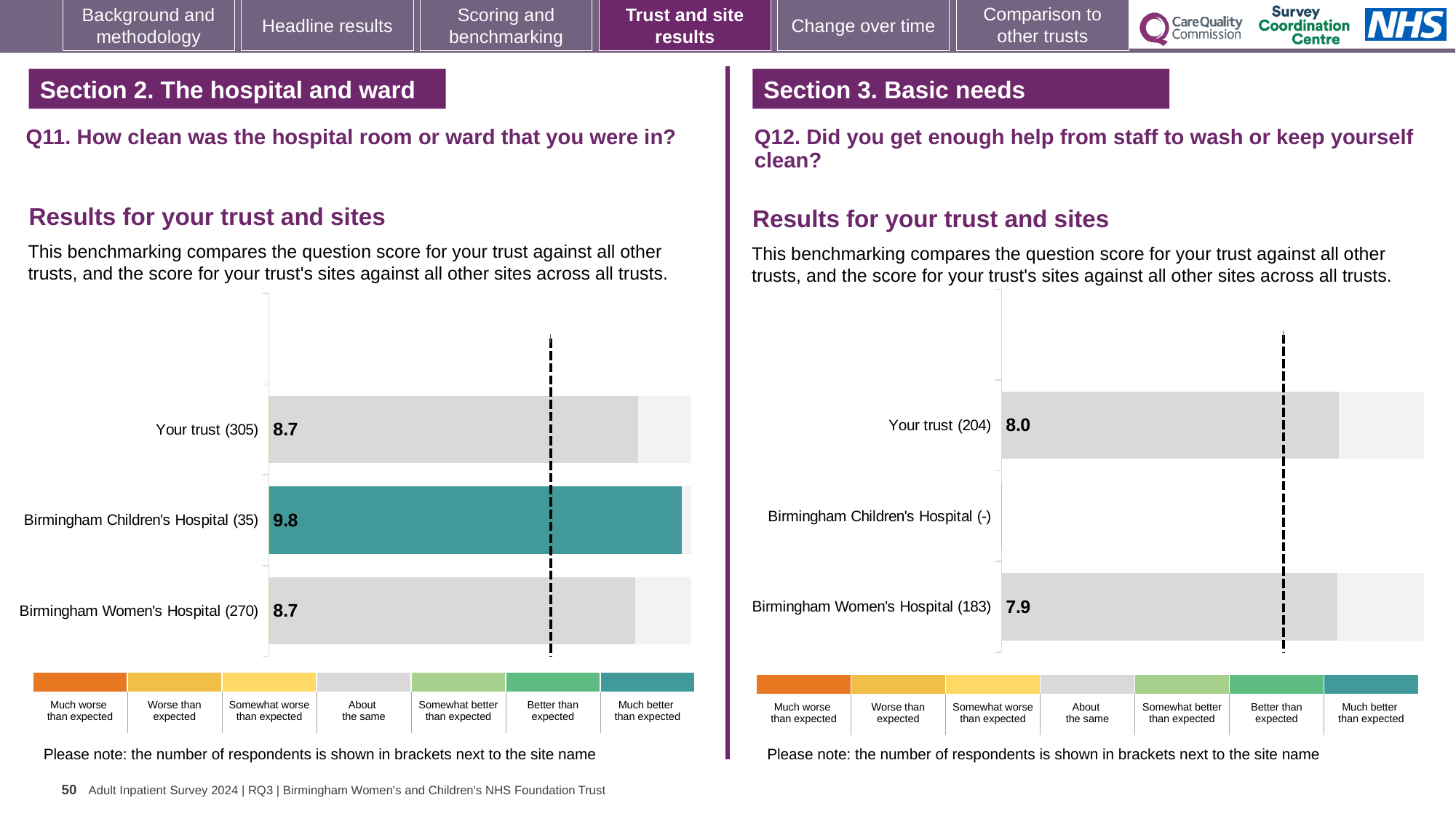
In the Q11 chart on the left, how many bars are plotted? 3 In the Q12 chart on the right, what is the score for Your trust? 8.0 In the Q11 chart on the left, what is the score for Birmingham Children's Hospital? 9.8 In the Q12 chart on the right, what is the score for Birmingham Women's Hospital? 7.9 In the Q11 chart on the left, how many respondents are shown for Birmingham Women's Hospital? 270 In the Q11 chart on the left, what is the score for Your trust? 8.7 In the Q11 chart on the left, which benchmark category does the colour of the Birmingham Children's Hospital bar correspond to? Much better than expected In the Q11 chart on the left, what is the difference between the scores for Birmingham Children's Hospital and Birmingham Women's Hospital? 1.1 What kind of chart is used for the Q11 results on the left? Bar chart In the Q12 chart on the right, how many respondents are shown for Your trust? 204 In the Q12 chart on the right, which is larger, the score for Your trust or for Birmingham Women's Hospital? Your trust In the Q11 chart on the left, which site has the highest score? Birmingham Children's Hospital